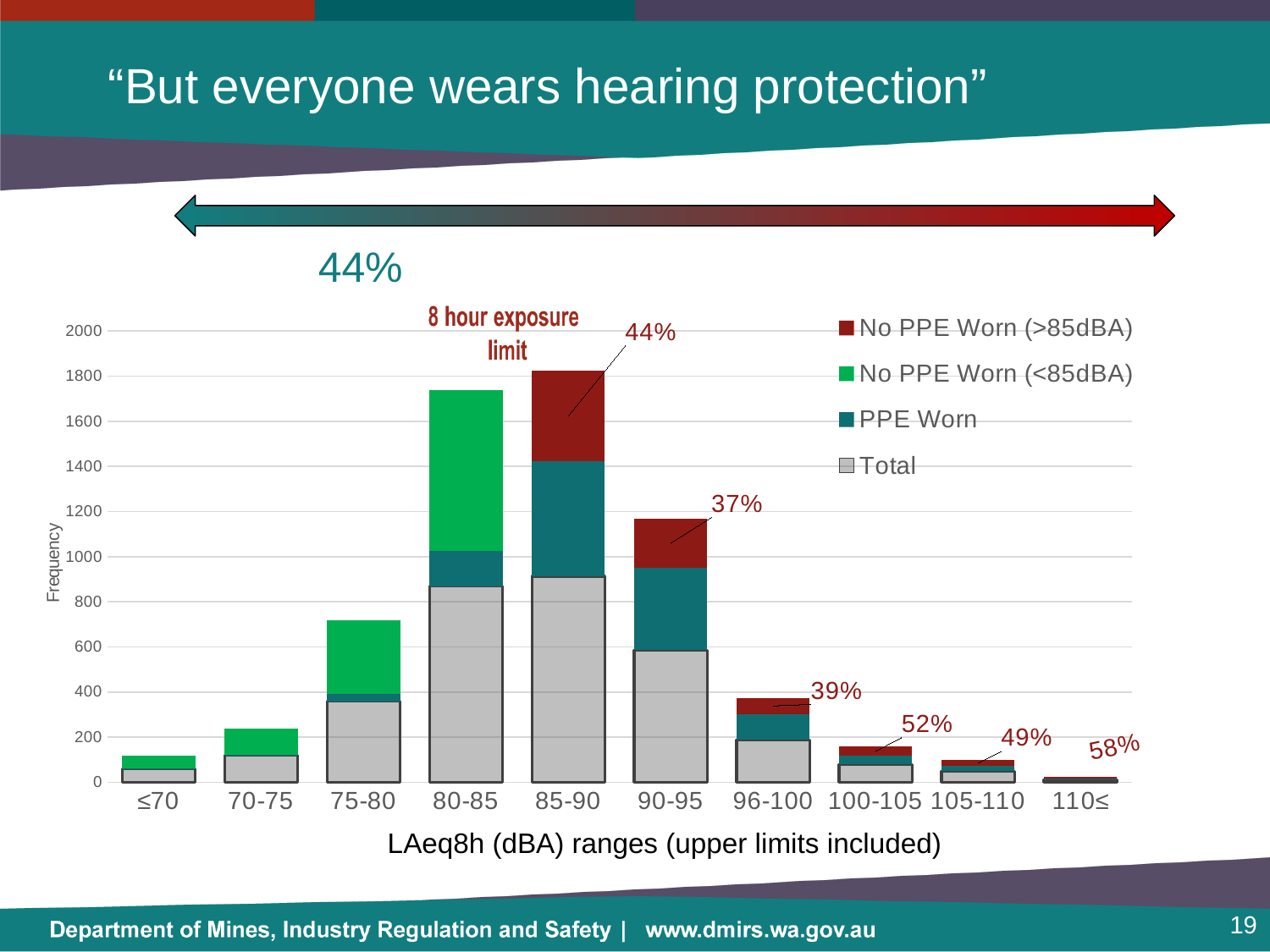
Which range has the taller stacked bar, 85-90 or 90-95? 85-90 What percentage label is shown for the 90-95 range? 37% What percentage label is shown for the 85-90 range? 44% Which range has the lowest percentage label? 90-95 What kind of chart is shown on the slide? bar chart What percentage label is shown for the 110≤ range? 58% How many LAeq8h range categories are shown on the x axis? 10 Is the total height of the 80-85 bar greater or less than 1600? greater What is the title of the y axis? Frequency Which range has the highest percentage label? 110≤ What is the difference between the percentage labels for 110≤ and 90-95? 21 percentage points How many series does the legend list? 4